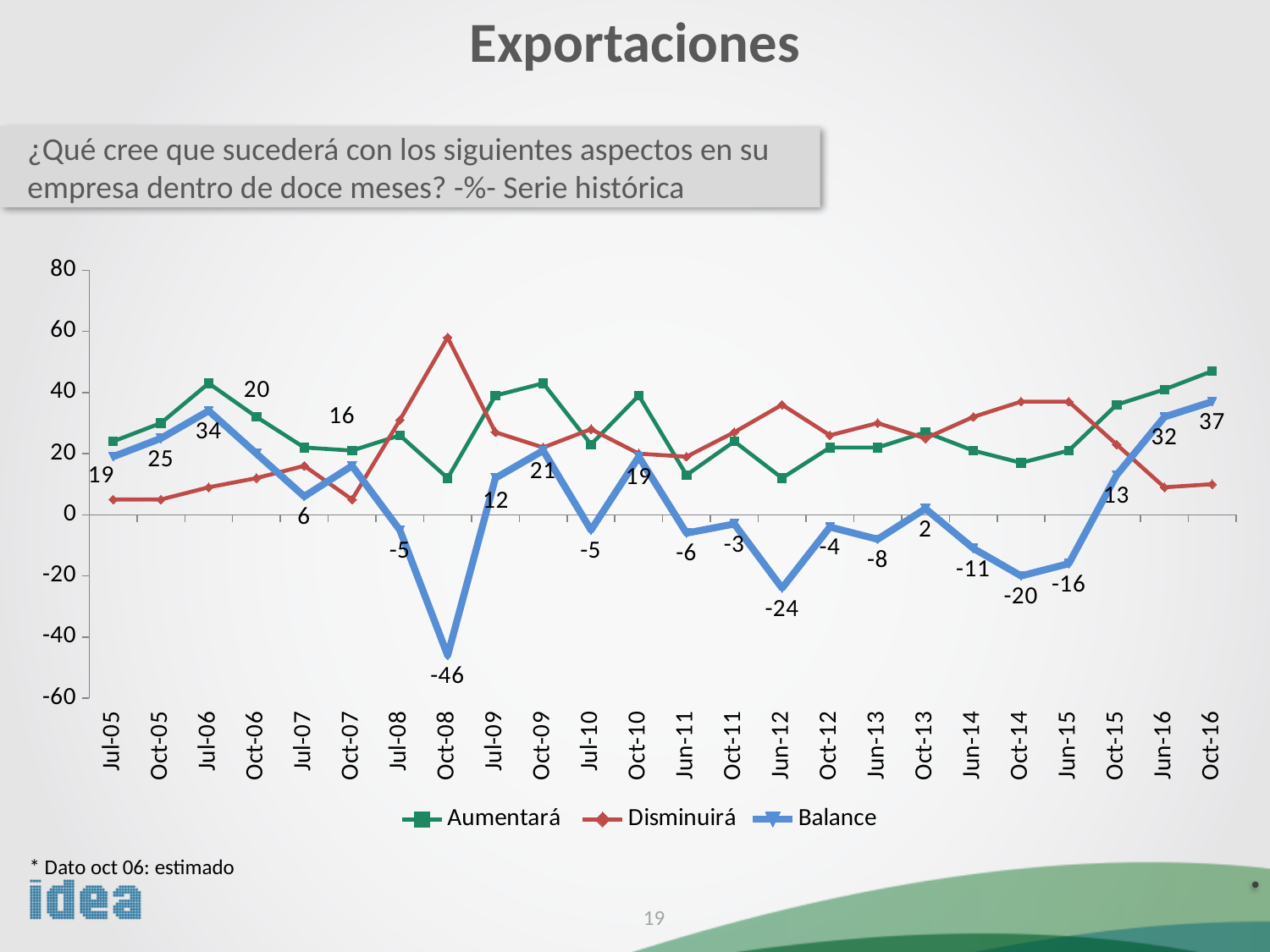
What is the value of the Balance series at Oct-16? 37 What is the difference between the Balance values at Jul-06 and Oct-06? 14 What kind of chart is shown on the slide? line chart At which date does the Balance series reach its highest value? Oct-16 What is the value of the Balance series at Jun-12? -24 At which date does the Balance series reach its lowest value? Oct-08 How many dates are shown on the x axis? 24 Is the value of the Disminuirá series at Oct-08 greater or less than 40? greater Which has a higher Balance value, Jul-05 or Oct-05? Oct-05 What is the difference between the Balance values at Oct-16 and Jun-16? 5 How many series does the legend list? 3 What is the value of the Balance series at Oct-08? -46